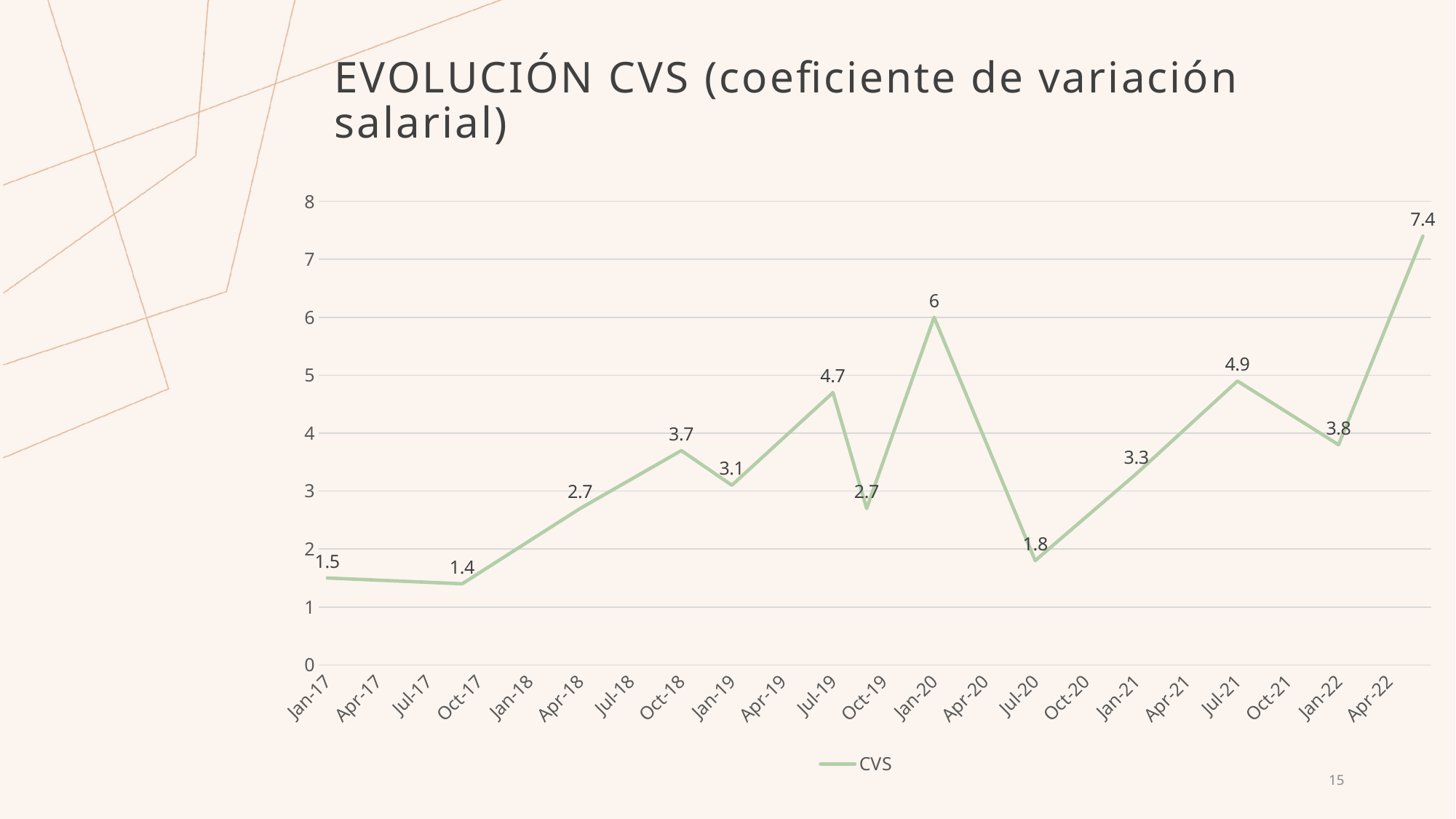
Is the value of the first data point greater or less than 2? less What is the difference between the highest and lowest values on the line? 6 How many labeled data points are plotted on the line? 13 What is the lowest value plotted on the line? 1.4 What is the value of the last data point on the line? 7.4 How many series does the legend list? 1 What type of chart is shown on the slide? line chart What is the name of the series shown in the legend? CVS Overall, does the CVS line rise or fall from the first point to the last point? rise What is the title of the chart? EVOLUCIÓN CVS (coeficiente de variación salarial) What is the highest value plotted on the line? 7.4 What is the value of the first data point (Jan-17)? 1.5